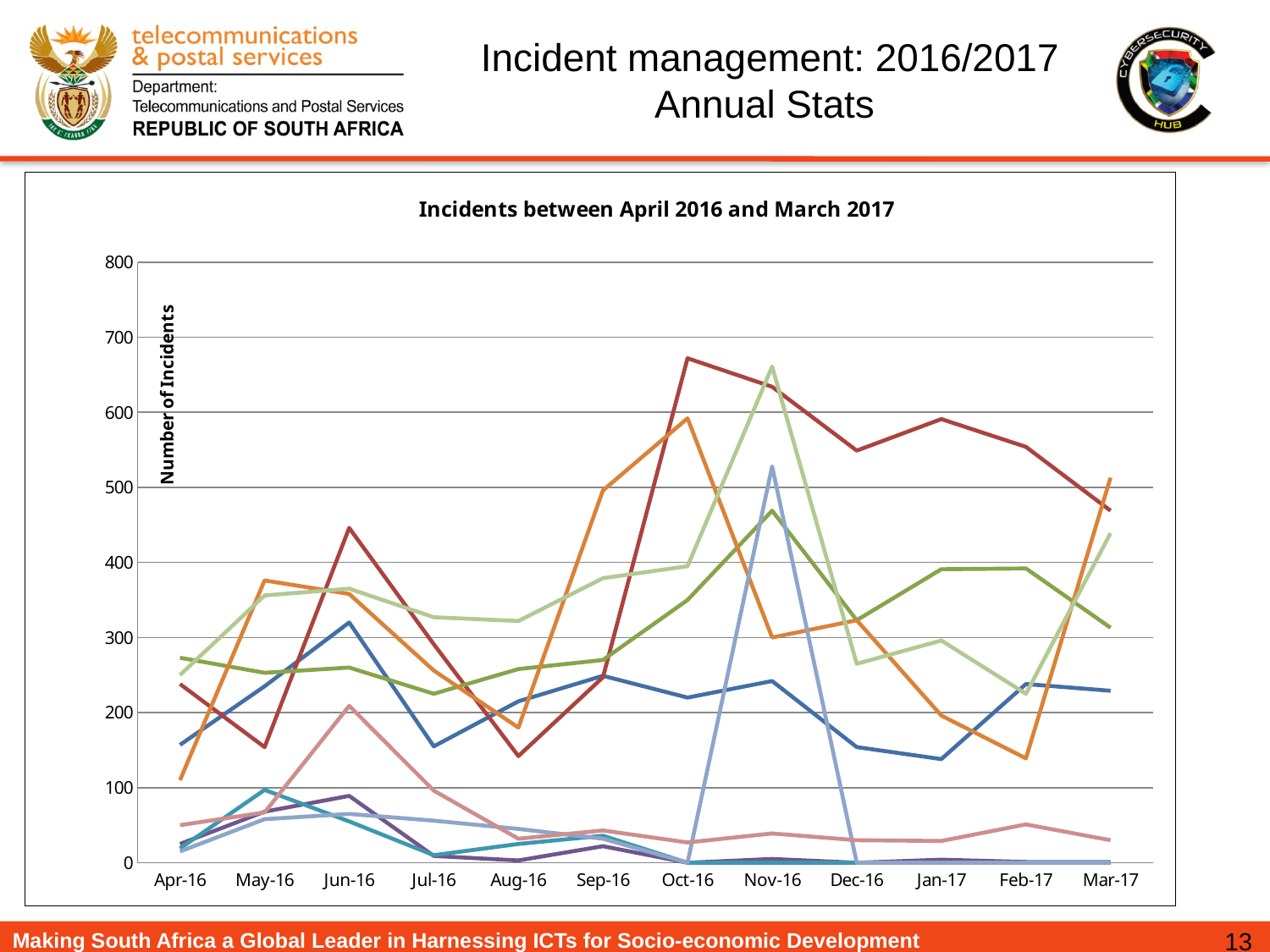
How many months are plotted along the x axis of the chart? 12 Which month is the first category on the x axis of the chart? Apr-16 In which month does the light blue line reach its highest point? Nov-16 Which month is the last category on the x axis of the chart? Mar-17 What kind of chart is shown on the slide? line chart In which month does the dark red line reach its highest point? Oct-16 What is the highest value shown on the vertical axis of the chart? 800 Is the value of the light blue line at Nov-16 greater or less than 500? greater What is the label on the vertical axis of the chart? Number of Incidents What is the title of the chart? Incidents between April 2016 and March 2017 Is the value of the dark red line at Oct-16 greater or less than 600? greater Is the value of the orange line at Apr-16 greater or less than 200? less